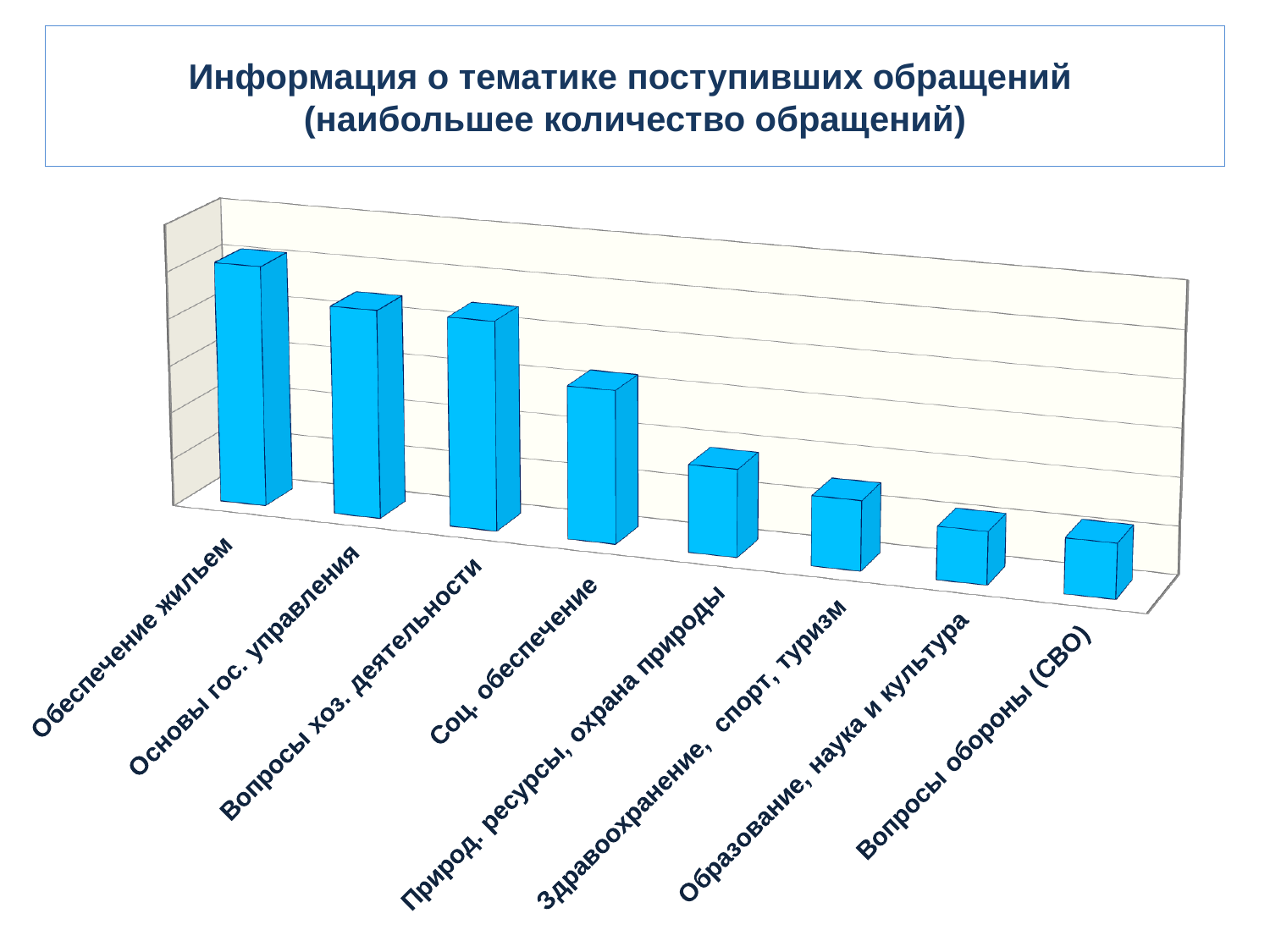
What colour are the bars in the chart? blue Which is larger, the value for Природ. ресурсы, охрана природы or the value for Образование, наука и культура? Природ. ресурсы, охрана природы Which category is plotted first (leftmost) on the x axis? Обеспечение жильем What kind of chart is shown on the slide? bar chart Do the values rise or fall moving from left to right along the x axis? fall Which category has the highest value in the chart? Обеспечение жильем Which is larger, the value for Основы гос. управления or the value for Вопросы обороны (СВО)? Основы гос. управления Which is larger, the value for Соц. обеспечение or the value for Здравоохранение, спорт, туризм? Соц. обеспечение What is the title of the chart on the slide? Информация о тематике поступивших обращений (наибольшее количество обращений) How many categories are plotted in the chart? 8